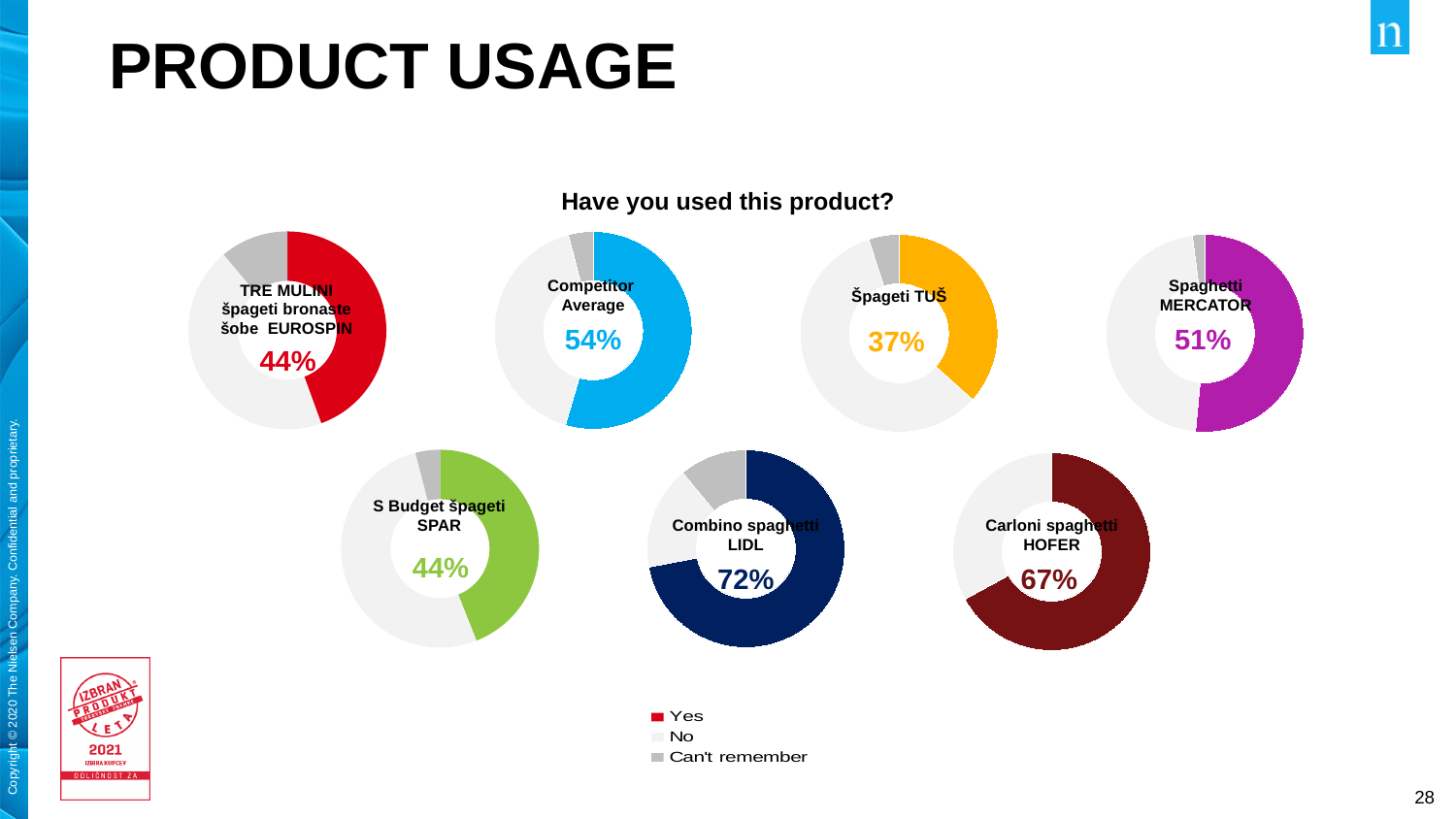
In the Carloni spaghetti HOFER chart, what percentage of respondents answered Yes? 67% What type of chart is used to show the product usage results? Pie (donut) chart Which has a higher Yes percentage: Spaghetti MERCATOR or the Competitor Average? Competitor Average In the Spaghetti MERCATOR chart, what percentage is shown? 51% In the Combino spaghetti LIDL chart, what percentage of respondents answered Yes? 72% In the Špageti TUŠ chart, what share of respondents said they had used the product? 37% In the Competitor Average chart, what is the printed Yes percentage? 54% What is the difference in percentage points between the Yes share for Combino spaghetti LIDL and Carloni spaghetti HOFER? 5 percentage points How many response categories does the legend list? 3 How many donut charts are shown on the slide? 7 Across all the donut charts on the slide, which product has the highest Yes percentage? Combino spaghetti LIDL Across all the donut charts on the slide, which product has the lowest Yes percentage? Špageti TUŠ